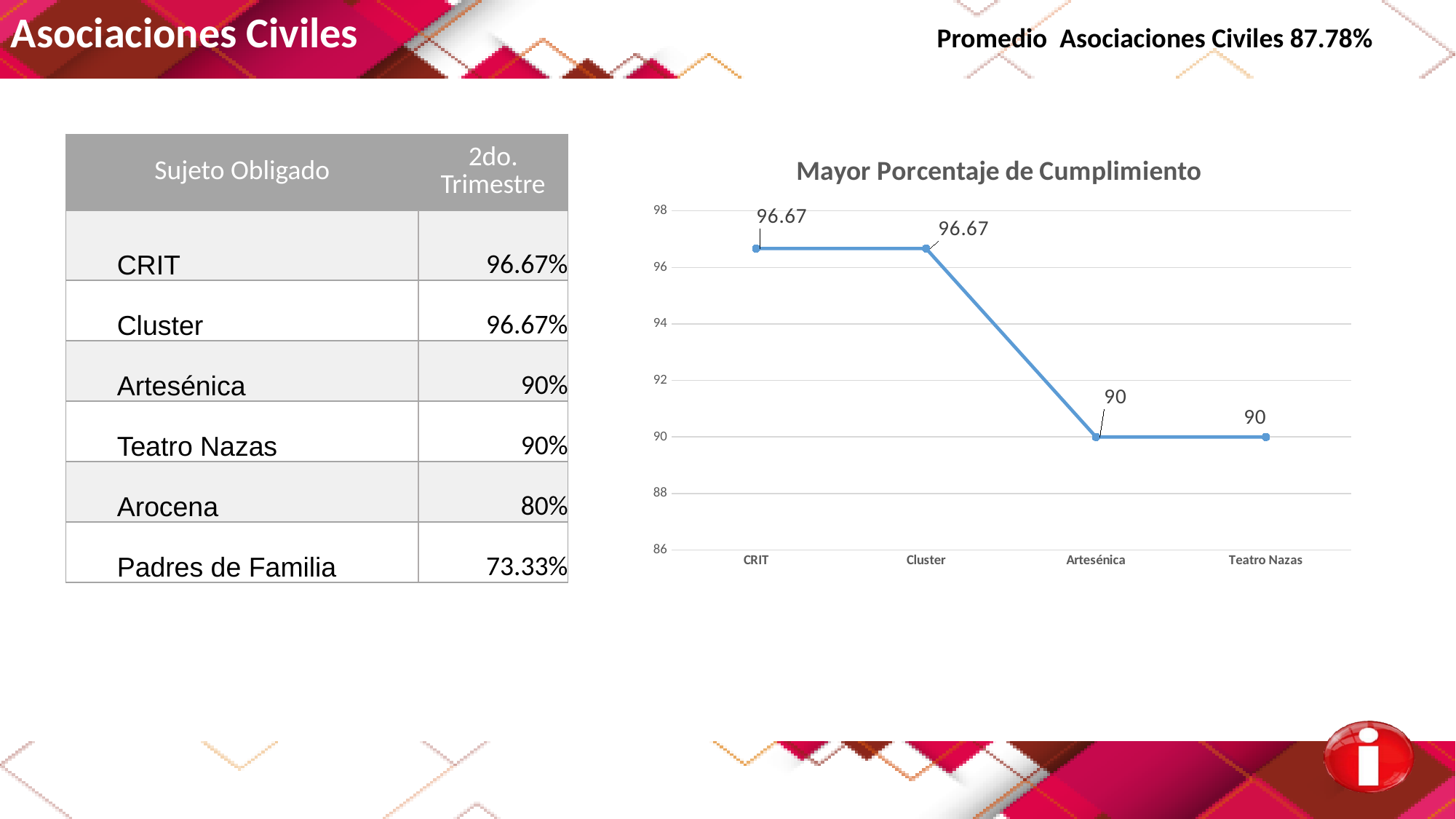
Is the value for Cluster greater or less than 94? greater Do the values rise or fall from CRIT to Teatro Nazas along the x axis? fall What is the value for CRIT in the chart? 96.67 What kind of chart is shown on the slide? line chart How many categories are plotted on the x axis of the chart? 4 What is the value for Cluster in the chart? 96.67 Which is larger, the value for CRIT or the value for Teatro Nazas? CRIT What is the value for Teatro Nazas in the chart? 90 Is the value for Artesénica greater or less than 92? less What is the title of the chart? Mayor Porcentaje de Cumplimiento What is the value for Artesénica in the chart? 90 What is the difference between the values for Cluster and Artesénica? 6.67